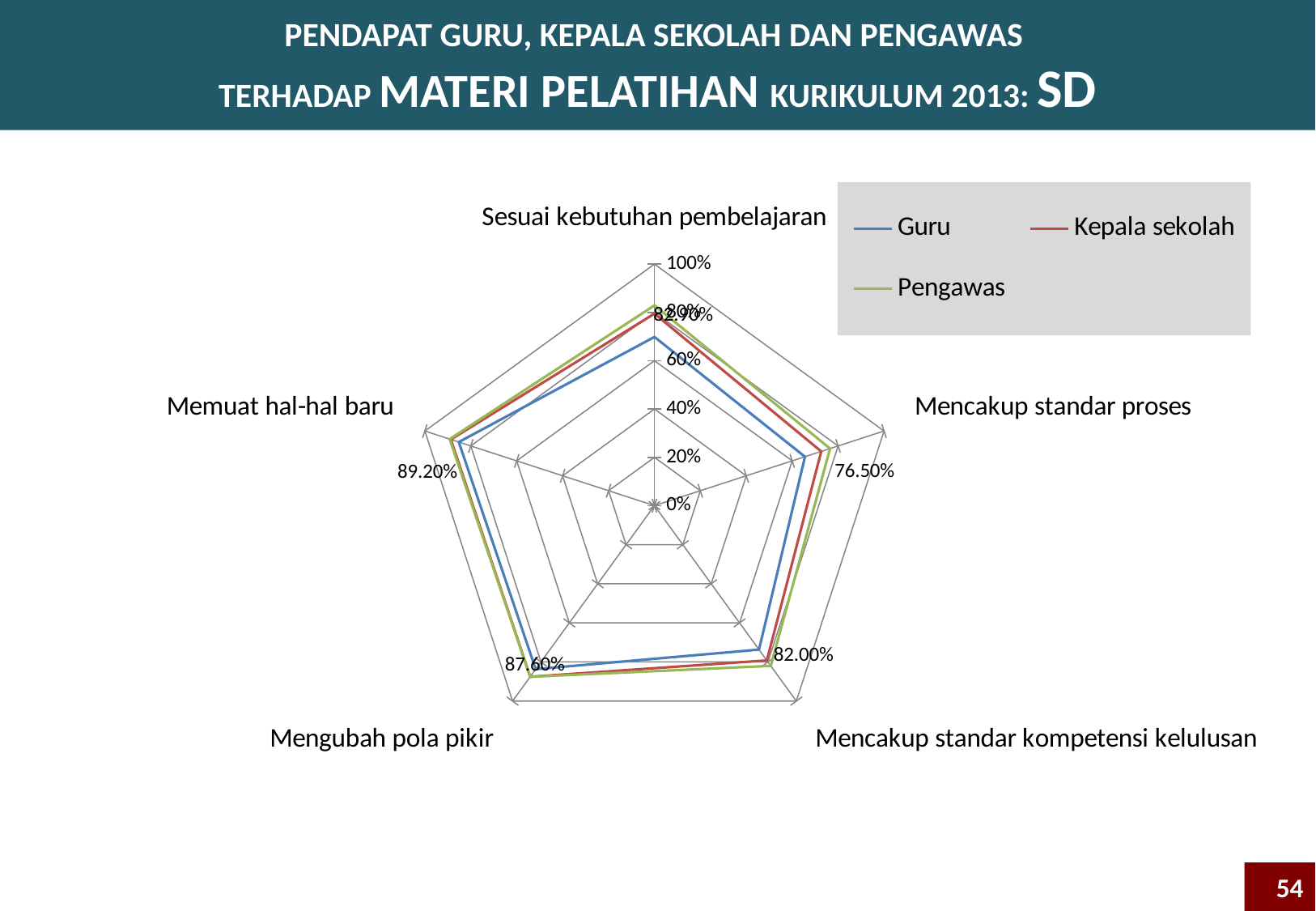
What data label is printed at the Memuat hal-hal baru axis? 89.20% What is the difference between the printed labels for Memuat hal-hal baru (89.20%) and Mencakup standar proses (76.50%)? 12.70% What data label is printed at the Mencakup standar kompetensi kelulusan axis? 82.00% How many categories (axes) does the radar chart have? 5 At Mengubah pola pikir, which series is larger: Guru or Pengawas? Pengawas Among the printed data labels, which category has the lowest value? Mencakup standar proses What data label is printed at the Mencakup standar proses axis? 76.50% How many series does the legend list? 3 What data label is printed at the Mengubah pola pikir axis? 87.60% Is the Guru value for Mencakup standar proses greater or less than 80%? less Among the printed data labels, which category has the highest value? Memuat hal-hal baru What kind of chart is shown on the slide? Radar chart